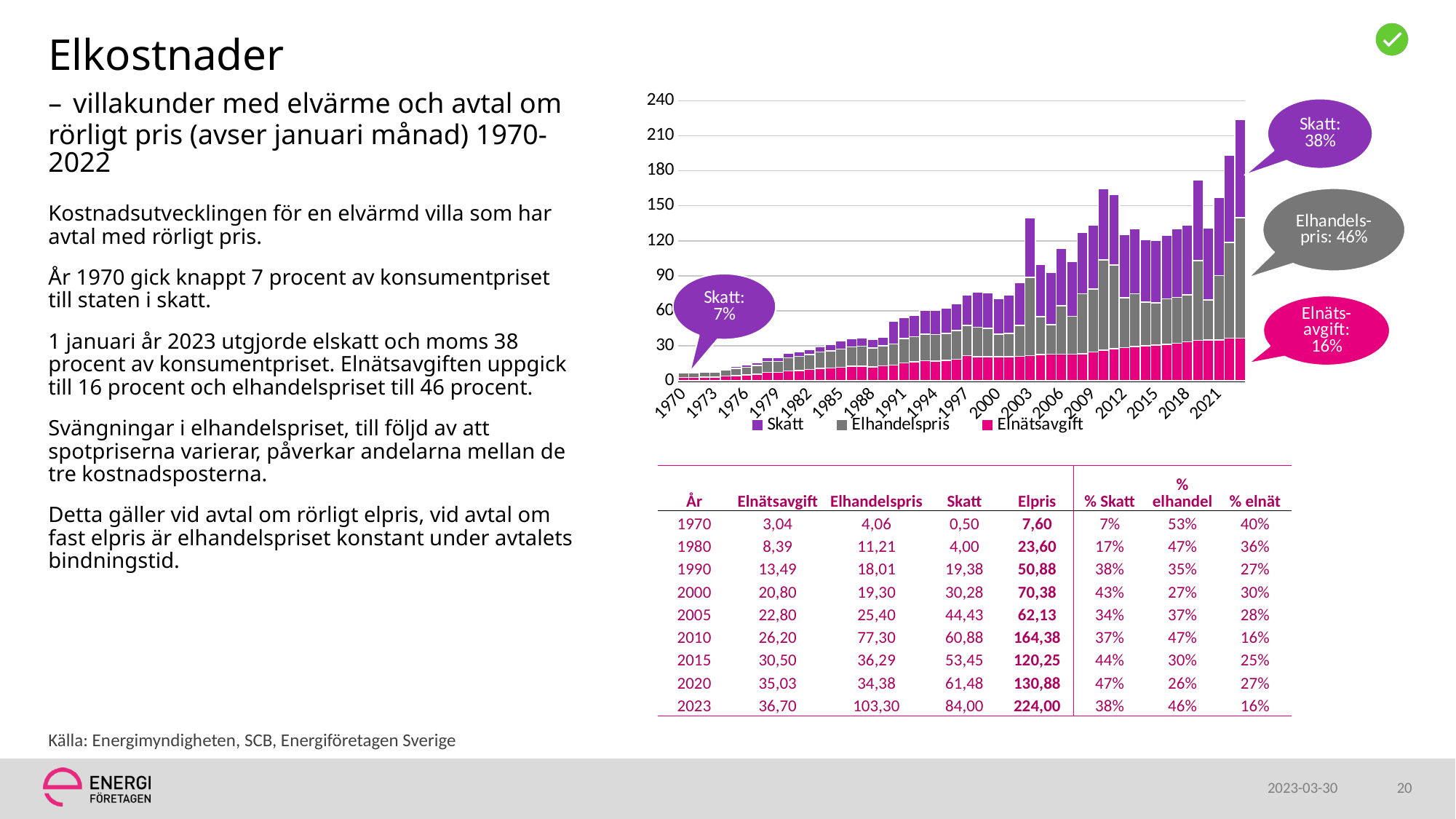
Do the total bar heights generally rise or fall from 1970 to 2021 along the x axis? rise Is the total for the rightmost bar in the chart greater or less than 210? greater Is the total bar for 2021 larger or smaller than the total bar for 1970? larger According to the table, what was Elpris in 2010? 164,38 Is the total for 1970 in the chart greater or less than 30? less Which series does the purple colour represent in the chart? Skatt Is the Elnätsavgift value for 2021 in the chart greater or less than 60? less How many series does the chart's legend list? 3 What kind of chart is shown on the slide? bar chart According to the table, what was Skatt in 2023? 84,00 According to the callout on the right of the chart, what share does Elhandelspris make up? 46% According to the table, which year has the highest Elpris? 2023